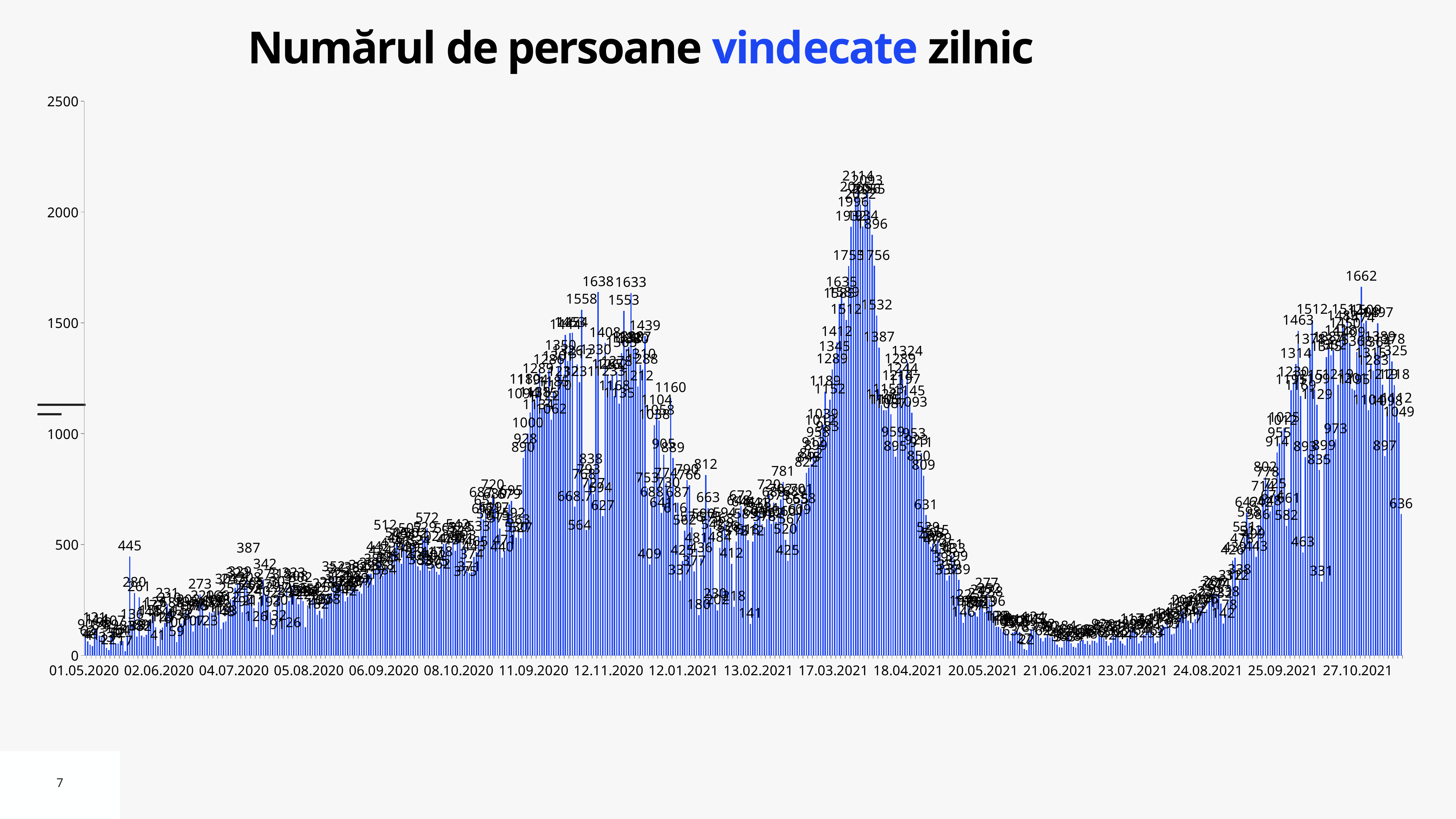
Which is larger: the peak value between 17.03.2021 and 18.04.2021 (2114) or the peak value after 25.09.2021 (1662)? the peak between 17.03.2021 and 18.04.2021 (2114) Do the values rise or fall between 20.05.2021 and 21.06.2021? fall What kind of chart is shown on the slide? bar chart Are the values around 21.06.2021 greater or less than 500? less What is the highest value labeled in the wave after 25.09.2021? 1662 What is the title of the chart? Numărul de persoane vindecate zilnic What is the highest value labeled in the peak around 12.11.2020? 1638 Is the highest value between 17.03.2021 and 18.04.2021 greater or less than 2000? greater What is the value of the tallest bar between 01.05.2020 and 02.06.2020? 445 What is the highest value labeled on the chart? 2114 What is the value of the tallest bar between 04.07.2020 and 05.08.2020? 387 What is the difference between the overall peak value of 2114 and the autumn 2021 peak value of 1662? 452